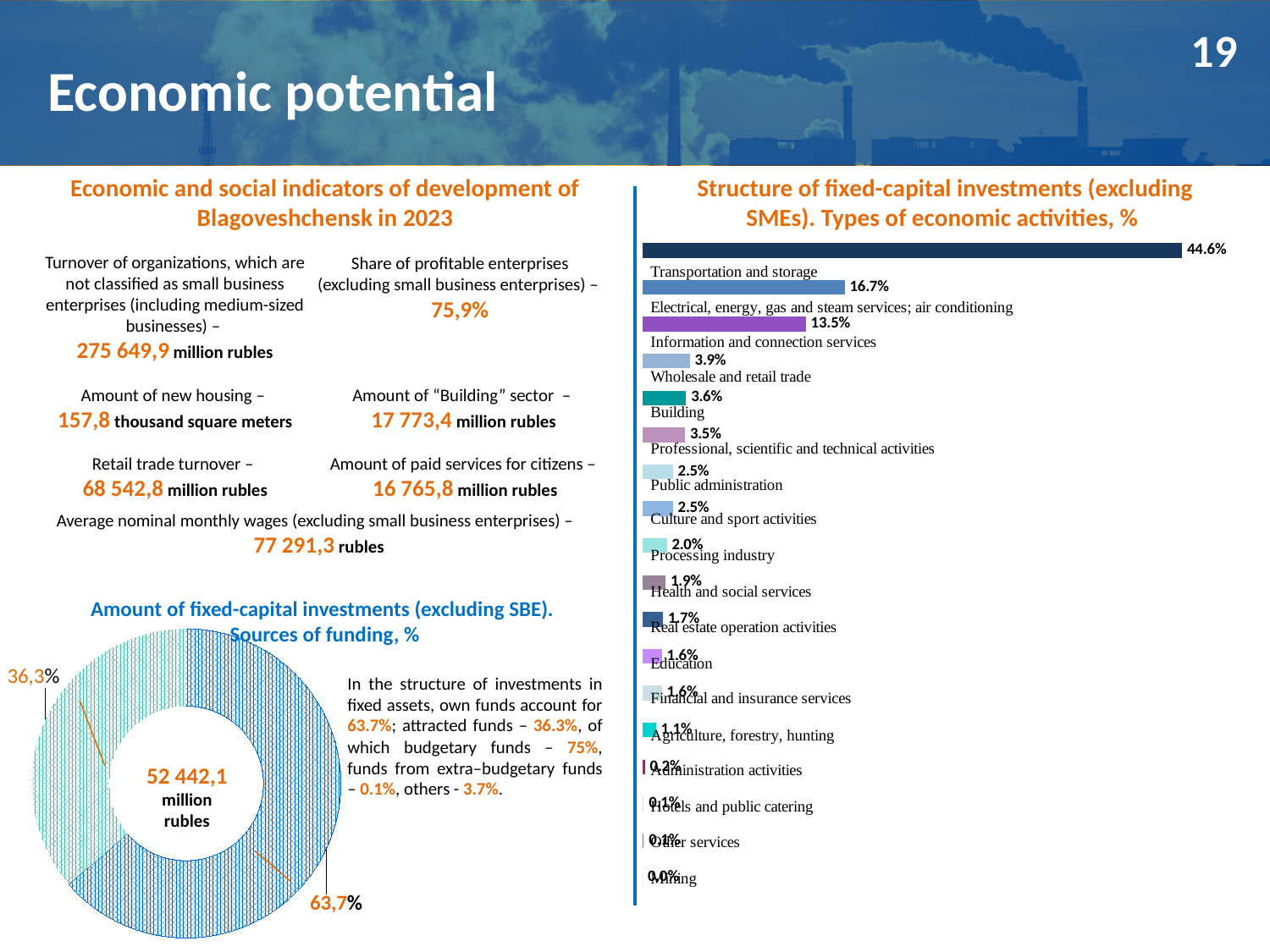
How many types of economic activities are shown in the 'Structure of fixed-capital investments' bar chart? 18 In the 'Sources of funding' donut chart, what is the smaller slice's share? 36,3% What total amount is shown in the centre of the 'Sources of funding' donut chart? 52 442,1 million rubles What kind of chart is the 'Structure of fixed-capital investments (excluding SMEs)' chart? Bar chart In the 'Structure of fixed-capital investments' bar chart, which type of economic activity has the highest share? Transportation and storage In the 'Structure of fixed-capital investments' bar chart, which type of economic activity has the lowest share? Mining In the 'Structure of fixed-capital investments' bar chart, what is the difference between Transportation and storage and Electrical, energy, gas and steam services; air conditioning? 27.9% In the 'Structure of fixed-capital investments' bar chart, which is larger: Wholesale and retail trade or Processing industry? Wholesale and retail trade In the 'Sources of funding' donut chart, what share do own funds account for? 63,7% In the 'Structure of fixed-capital investments' bar chart, what is the value for Building? 3.6% In the 'Structure of fixed-capital investments' bar chart, what is the value for Information and connection services? 13.5% In the 'Structure of fixed-capital investments' bar chart, what is the value for Transportation and storage? 44.6%